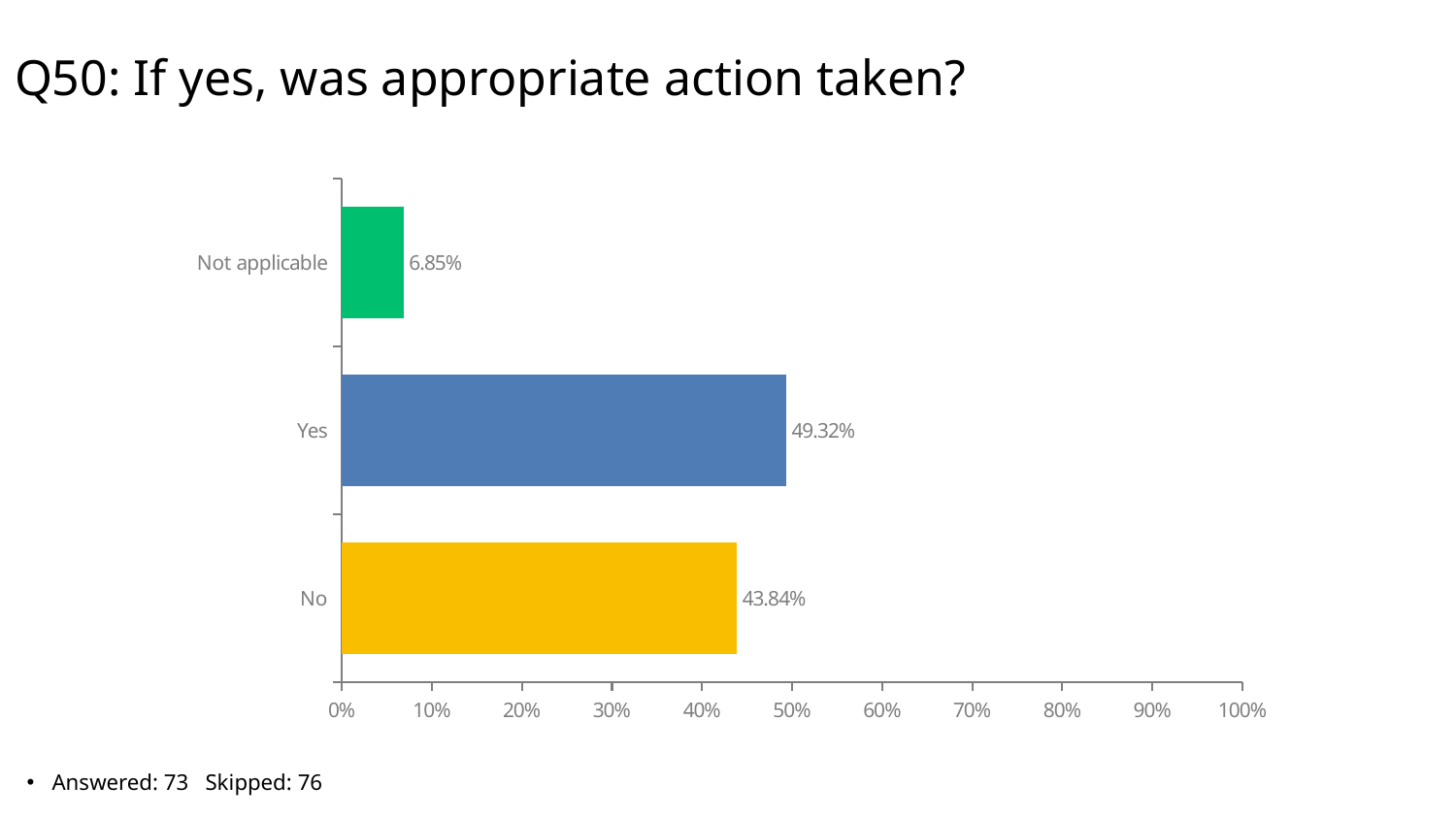
What percentage of respondents answered "Not applicable"? 6.85% What colour is the bar for "No"? Yellow Which is larger, the percentage for "Yes" or for "No"? Yes What percentage of respondents answered "Yes"? 49.32% Is the value for "No" greater or less than 50%? less What is the difference in percentage points between "Yes" and "No"? 5.48% What is the difference in percentage points between "No" and "Not applicable"? 36.99% What percentage of respondents answered "No"? 43.84% Which response category has the lowest percentage? Not applicable How many response categories are shown in the chart? 3 What kind of chart is shown on the slide? Bar chart Which response category has the highest percentage? Yes